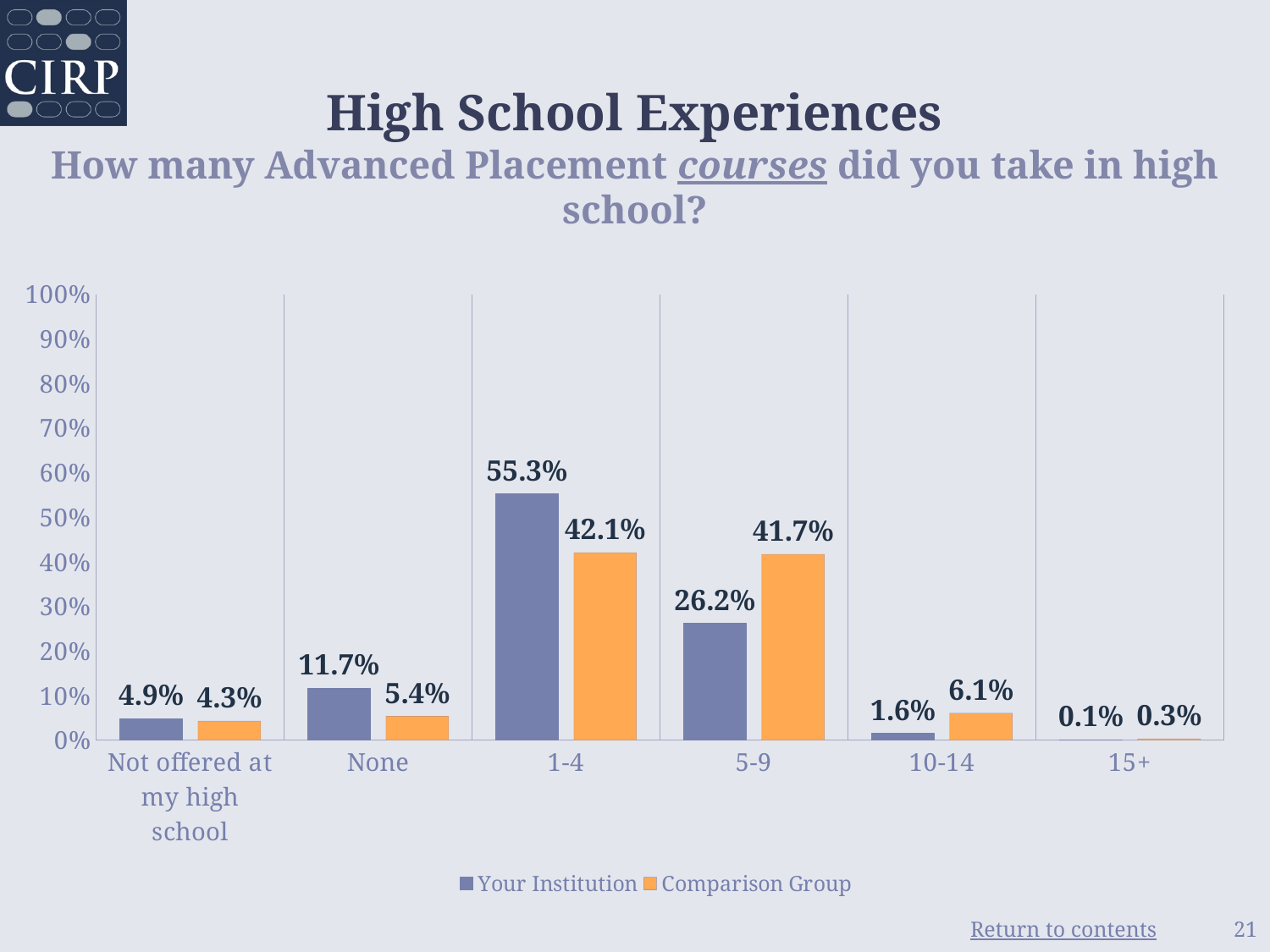
How many categories are shown on the x axis? 6 What is the value for Comparison Group in the 10-14 category? 6.1% How many series does the legend list? 2 What is the value for Your Institution in the 1-4 category? 55.3% Which category has the highest value for Your Institution? 1-4 What is the value for Comparison Group in the 5-9 category? 41.7% What kind of chart is shown on the slide? Bar chart What is the value for Your Institution in the None category? 11.7% What colour represents the Comparison Group series? Orange Which category has the lowest value for Comparison Group? 15+ Which is larger in the None category, Your Institution or Comparison Group? Your Institution What is the difference between Your Institution and Comparison Group in the 5-9 category? 15.5%